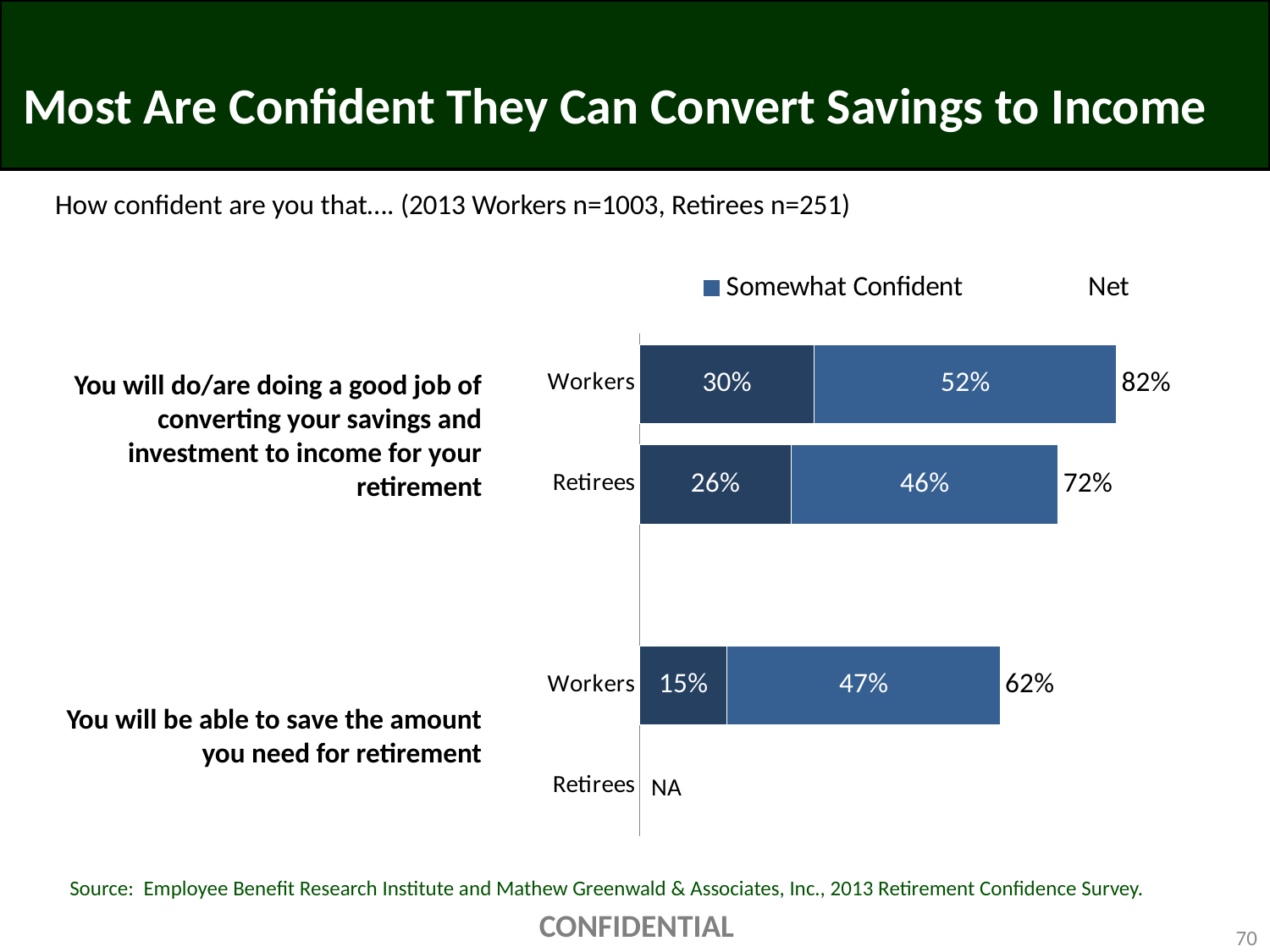
What is the Net value for Workers on "You will be able to save the amount you need for retirement"? 62% What is shown for Retirees on "You will be able to save the amount you need for retirement"? NA What is the Net value for Workers on "You will do/are doing a good job of converting your savings and investment to income for your retirement"? 82% What is the Somewhat Confident value for Retirees on "You will do/are doing a good job of converting your savings and investment to income for your retirement"? 46% What is the Net value for Retirees on "You will do/are doing a good job of converting your savings and investment to income for your retirement"? 72% What is the Somewhat Confident value for Workers on "You will do/are doing a good job of converting your savings and investment to income for your retirement"? 52% What is the difference between the Net values for Workers and Retirees on converting savings and investment to income for retirement? 10 percentage points Which bar has the highest Net value on the chart? Workers, converting savings and investment to income for retirement (82%) What type of chart is shown on the slide? Stacked bar chart What is the Somewhat Confident value for Workers on "You will be able to save the amount you need for retirement"? 47% What is the difference between the Somewhat Confident values for Workers on converting savings to income (52%) and Workers on saving the amount needed for retirement (47%)? 5 percentage points On converting savings and investment to income for retirement, which group has the larger Somewhat Confident value, Workers or Retirees? Workers